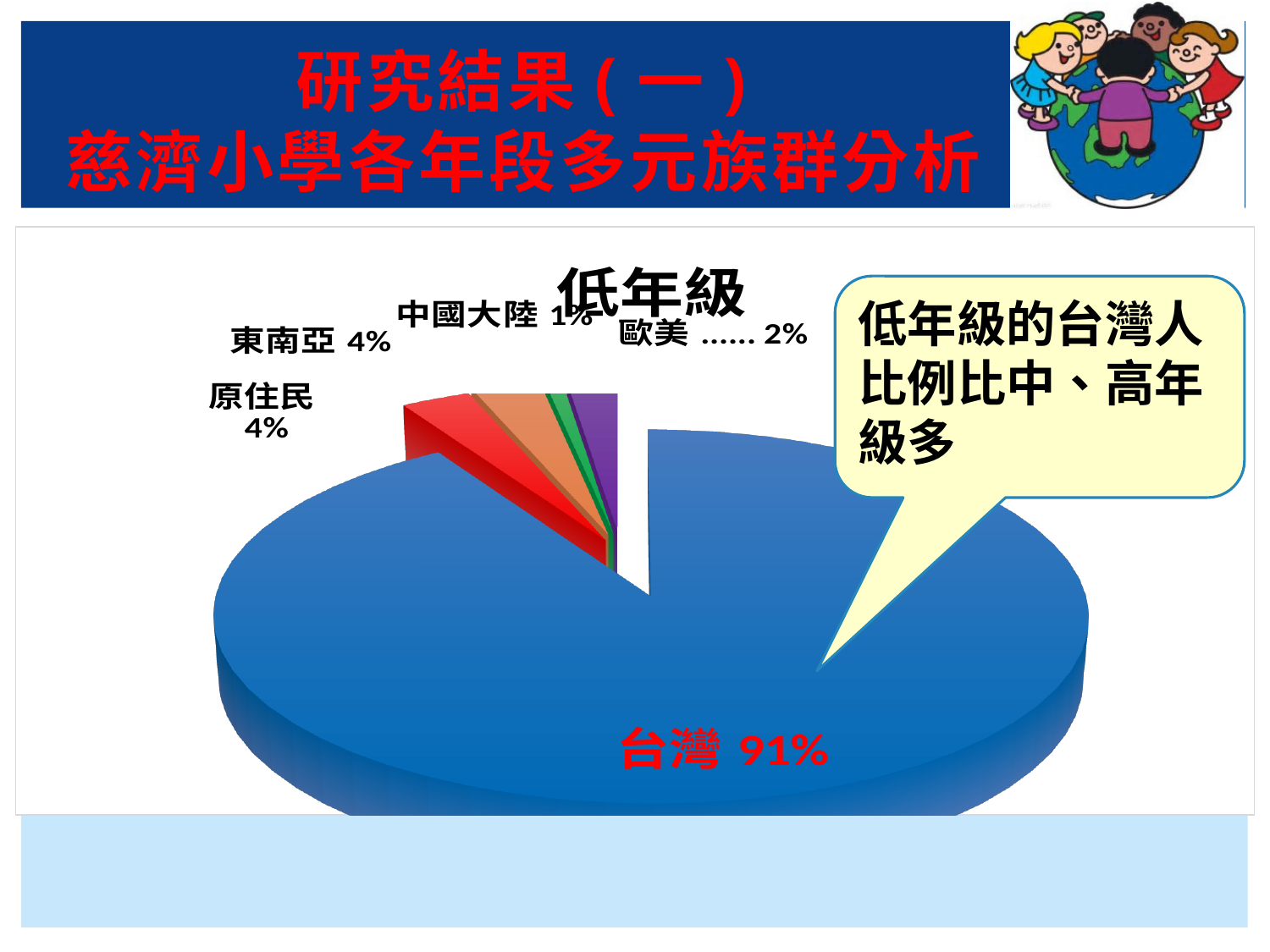
How many slices does the pie chart have? 5 What percentage does the 原住民 slice represent? 4% Which category has the largest share of the pie? 台灣 Which is larger, the share for 原住民 or the share for 歐美? 原住民 Which category has the smallest share of the pie? 中國大陸 What percentage does the 台灣 slice represent? 91% What is the difference between the 台灣 share and the 歐美 share? 89% What kind of chart is shown on the slide? pie chart What percentage does the 東南亞 slice represent? 4% What colour is the 台灣 slice of the pie? blue What is the title of the pie chart? 低年級 What percentage does the 歐美 slice represent? 2%